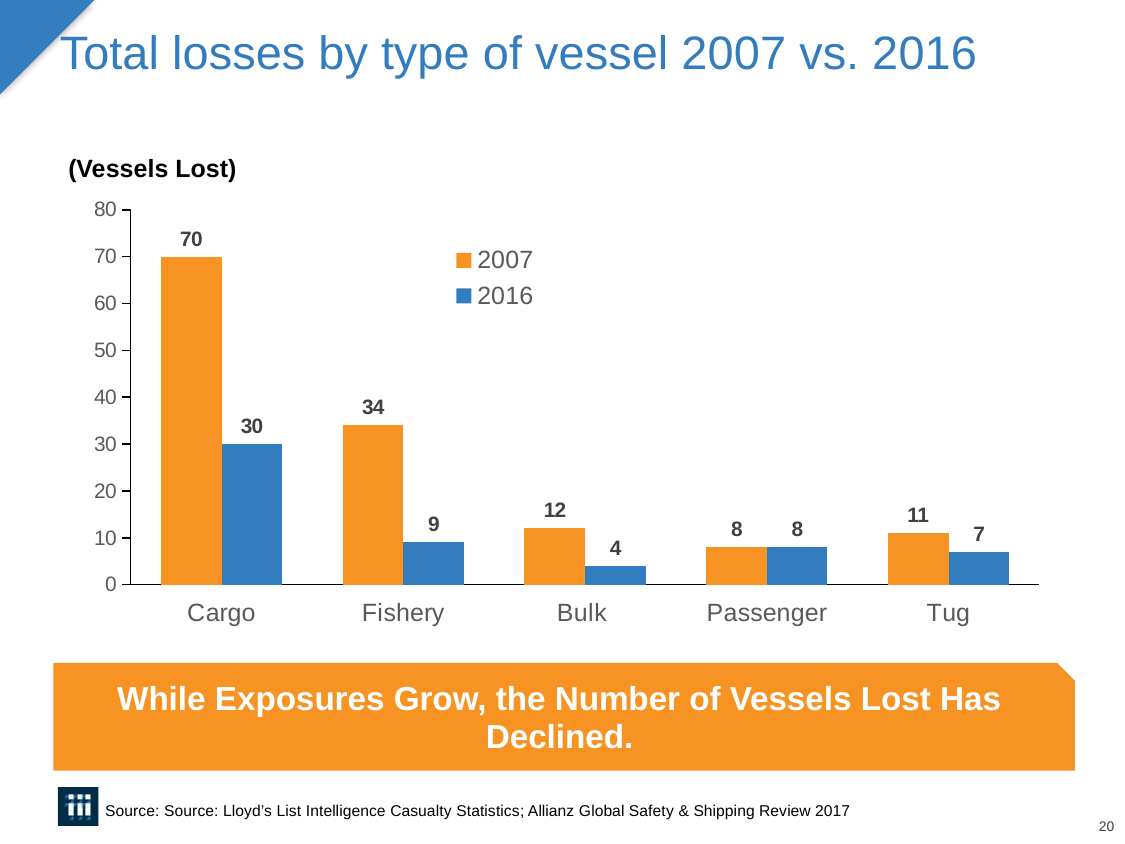
What is the value for Fishery in 2016? 9 What is the difference between the 2007 and 2016 values for Cargo? 40 Which vessel type had the highest number of losses in 2007? Cargo How many series does the legend list? 2 What kind of chart is shown on the slide? Bar chart Which vessel type had the lowest number of losses in 2016? Bulk What is the difference between the 2007 and 2016 values for Fishery? 25 What is the value for Tug in 2007? 11 How many vessels were lost in the Cargo category in 2007? 70 Which is larger, the 2007 value for Bulk or the 2016 value for Bulk? 2007 How many vessel types are shown on the x axis? 5 Which colour represents the 2016 series in the chart? Blue